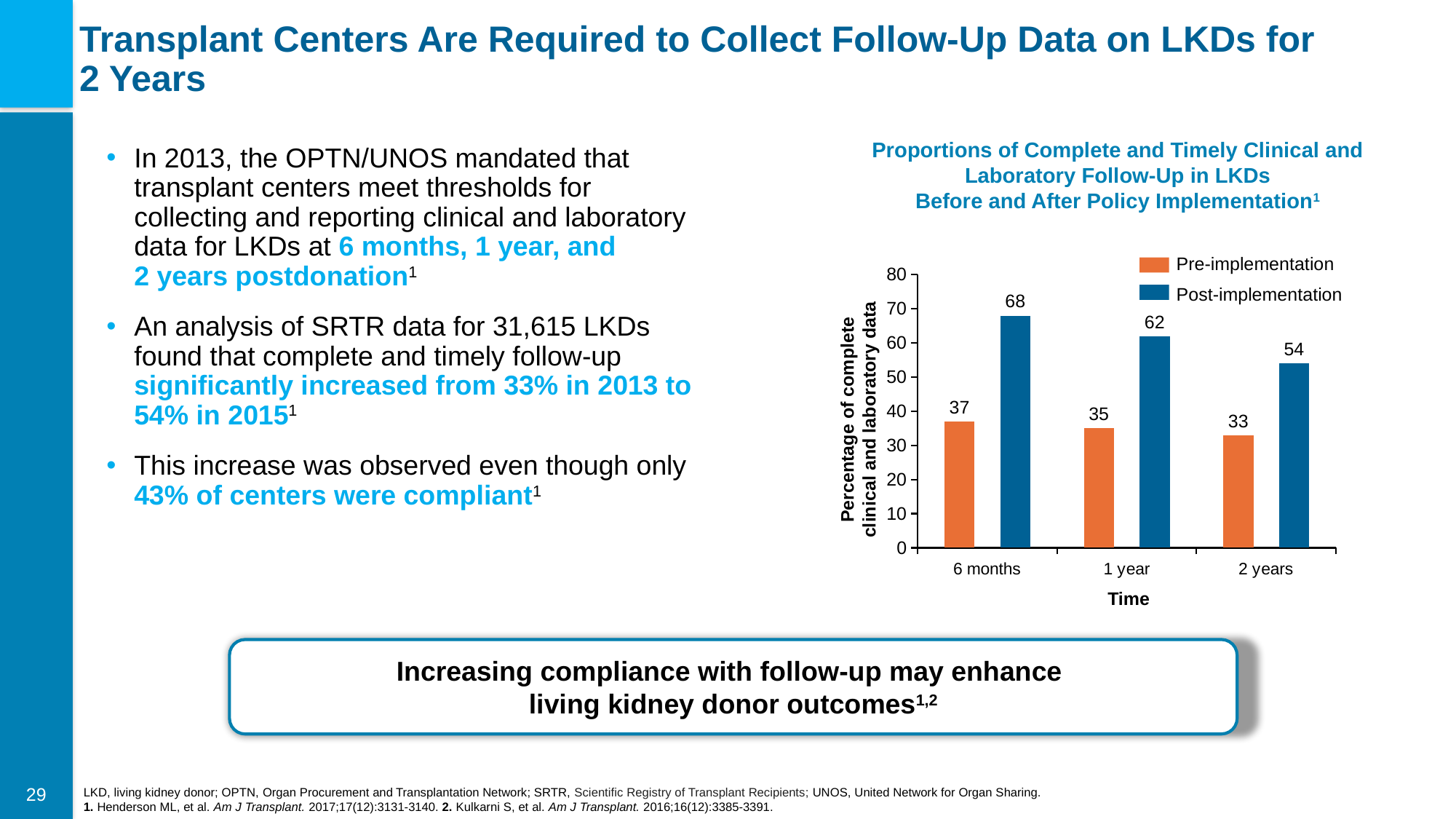
How many series does the legend list? 2 Do the Post-implementation values rise or fall from 6 months to 2 years? Fall What is the Pre-implementation value at 1 year? 35 What is the Pre-implementation value at 2 years? 33 How many time points are shown on the x axis? 3 Which is larger at 2 years: the Pre-implementation or the Post-implementation value? Post-implementation What is the difference between the Post-implementation and Pre-implementation values at 1 year? 27 Which time point has the lowest Pre-implementation value? 2 years What kind of chart is shown on the slide? Bar chart What is the Post-implementation value at 6 months? 68 Which time point has the highest Post-implementation value? 6 months What is the difference between the Post-implementation values at 6 months and 2 years? 14